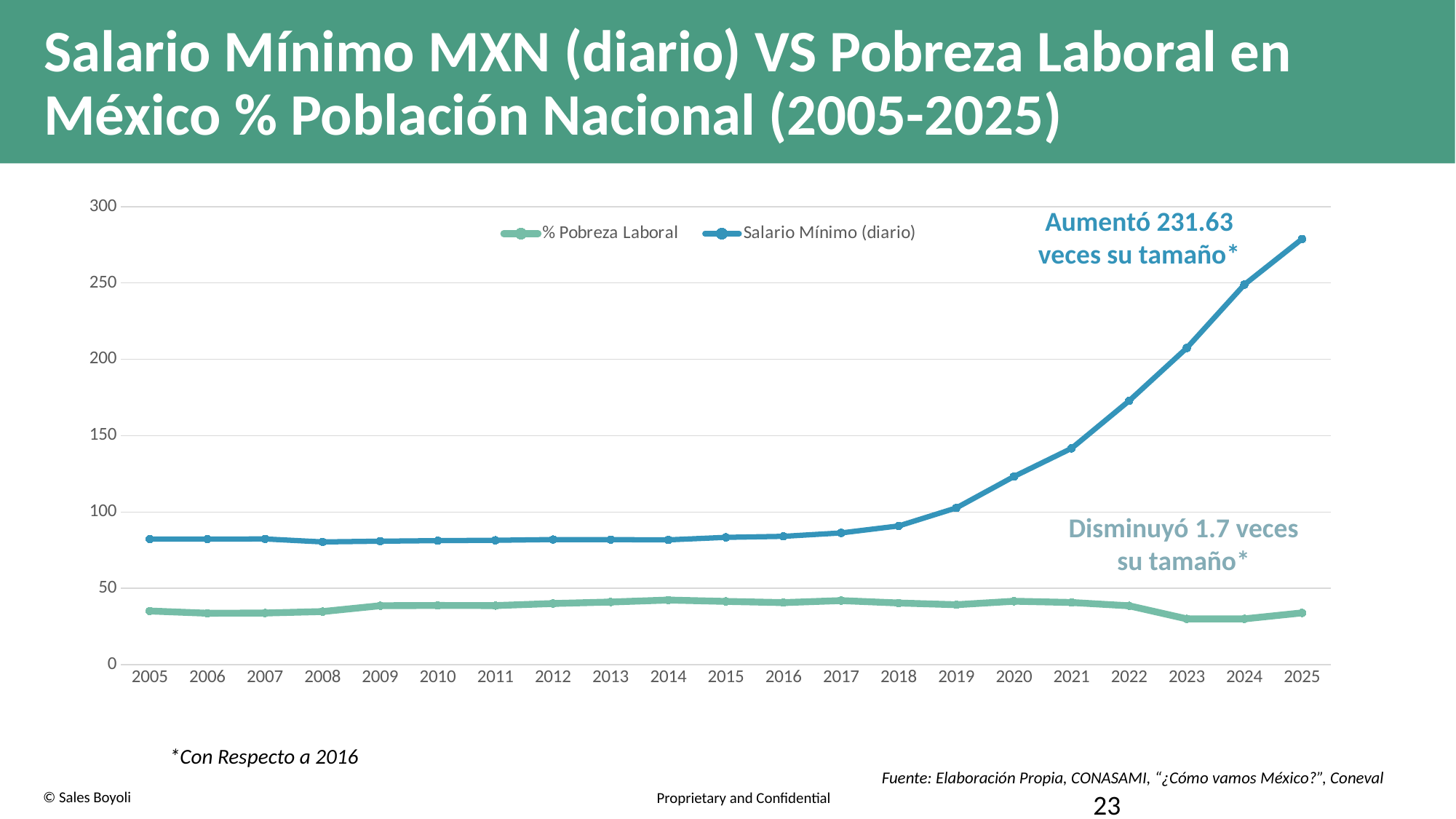
In which year is the Salario Mínimo (diario) series at its highest? 2025 Is the value for Salario Mínimo (diario) in 2025 greater or less than 250? greater What kind of chart is shown on the slide? line chart Is the value for % Pobreza Laboral in 2025 greater or less than 50? less How many series does the legend list? 2 Is the value for Salario Mínimo (diario) in 2023 greater or less than 200? greater How many years are plotted along the x axis? 21 Which series is drawn in blue? Salario Mínimo (diario) Which is larger, the Salario Mínimo (diario) value in 2005 or in 2025? 2025 Does the Salario Mínimo (diario) series rise or fall between 2018 and 2025? rise According to the annotation on the chart, by how many times did the Salario Mínimo increase with respect to 2016? 231.63 veces